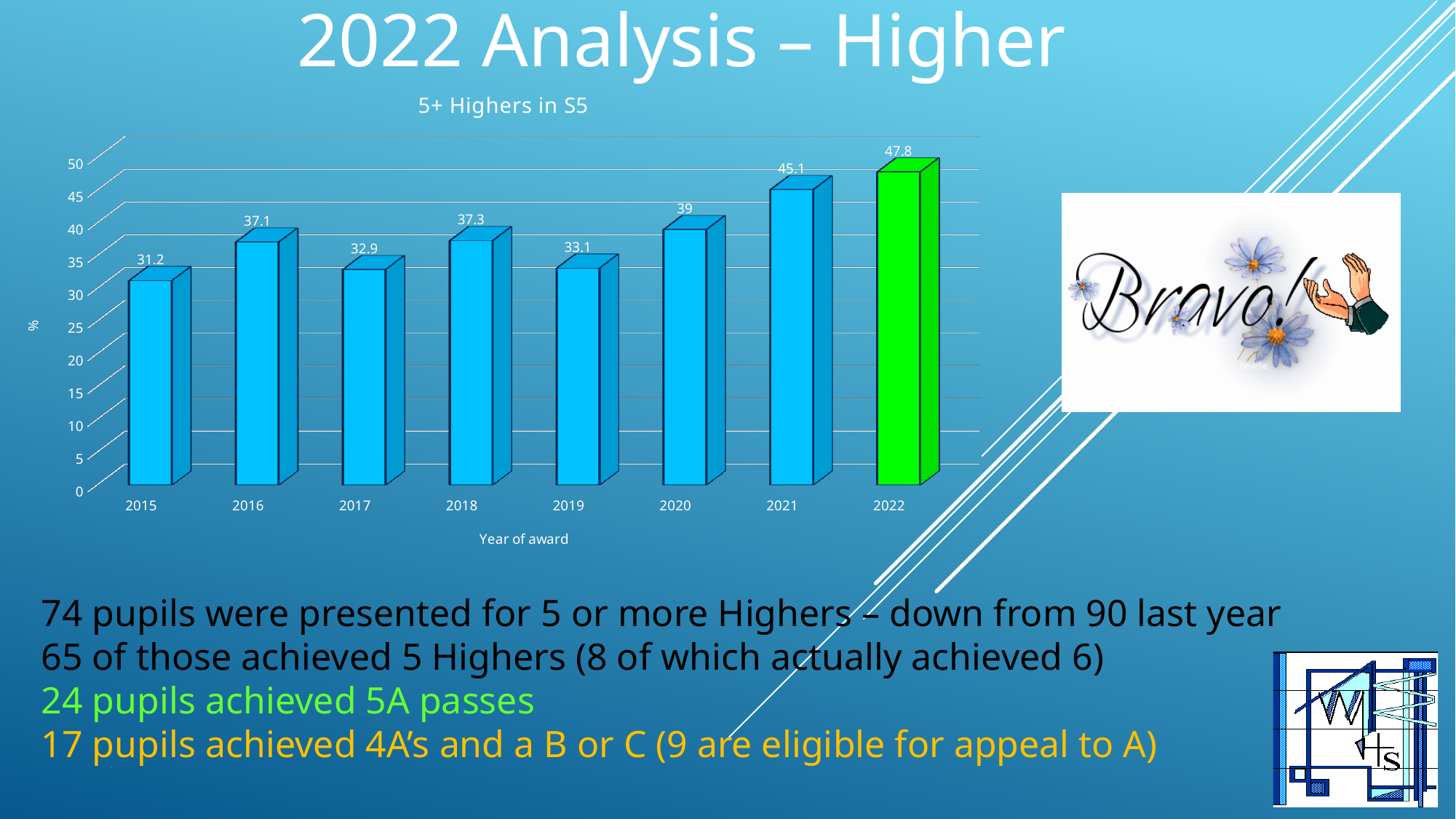
Which year has the highest value in the chart? 2022 What kind of chart is shown on the slide? bar chart Which is larger, the value for 2018 or the value for 2019? 2018 How many years are shown on the x axis of the chart? 8 What is the value for 2022 in the chart? 47.8 What is the value for 2015 in the chart? 31.2 Which year has the lowest value in the chart? 2015 What is the difference between the values for 2016 and 2017? 4.2 Is the value for 2021 greater or less than 40? greater What is the title of the chart? 5+ Highers in S5 What is the value for 2020 in the chart? 39 What is the difference between the values for 2022 and 2021? 2.7